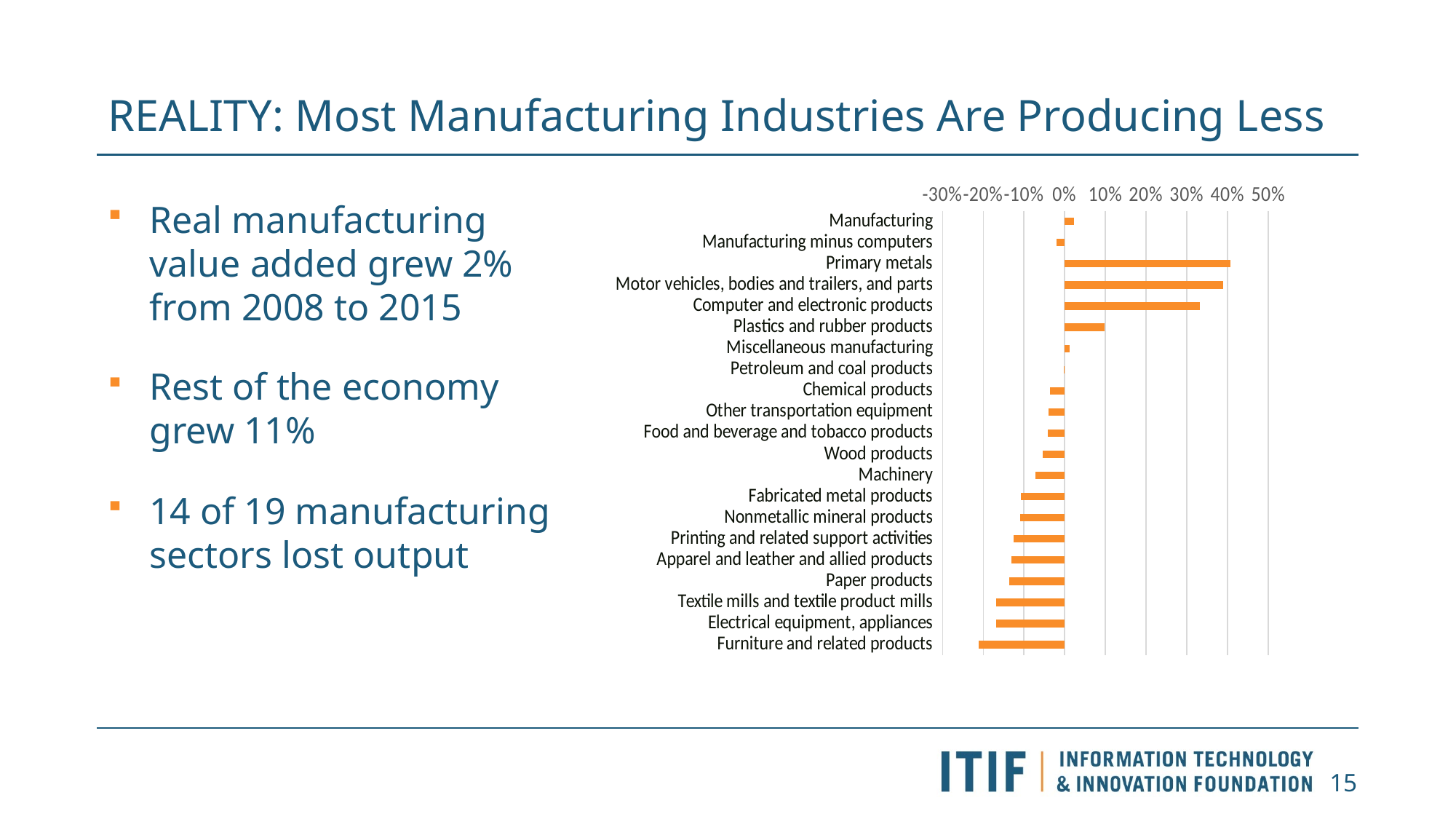
Is the value for Computer and electronic products greater or less than 20%? greater What kind of chart is shown on the slide? Bar chart Is the value for Furniture and related products greater or less than -10%? less How many categories are plotted in the chart? 21 Which category has the lowest value in the chart? Furniture and related products Which category has the highest value in the chart? Primary metals Which is larger, the value for Paper products or the value for Furniture and related products? Paper products Is the value for Chemical products greater or less than -10%? greater What is the lowest value shown on the chart's horizontal axis? -30% Which is larger, the value for Primary metals or the value for Computer and electronic products? Primary metals